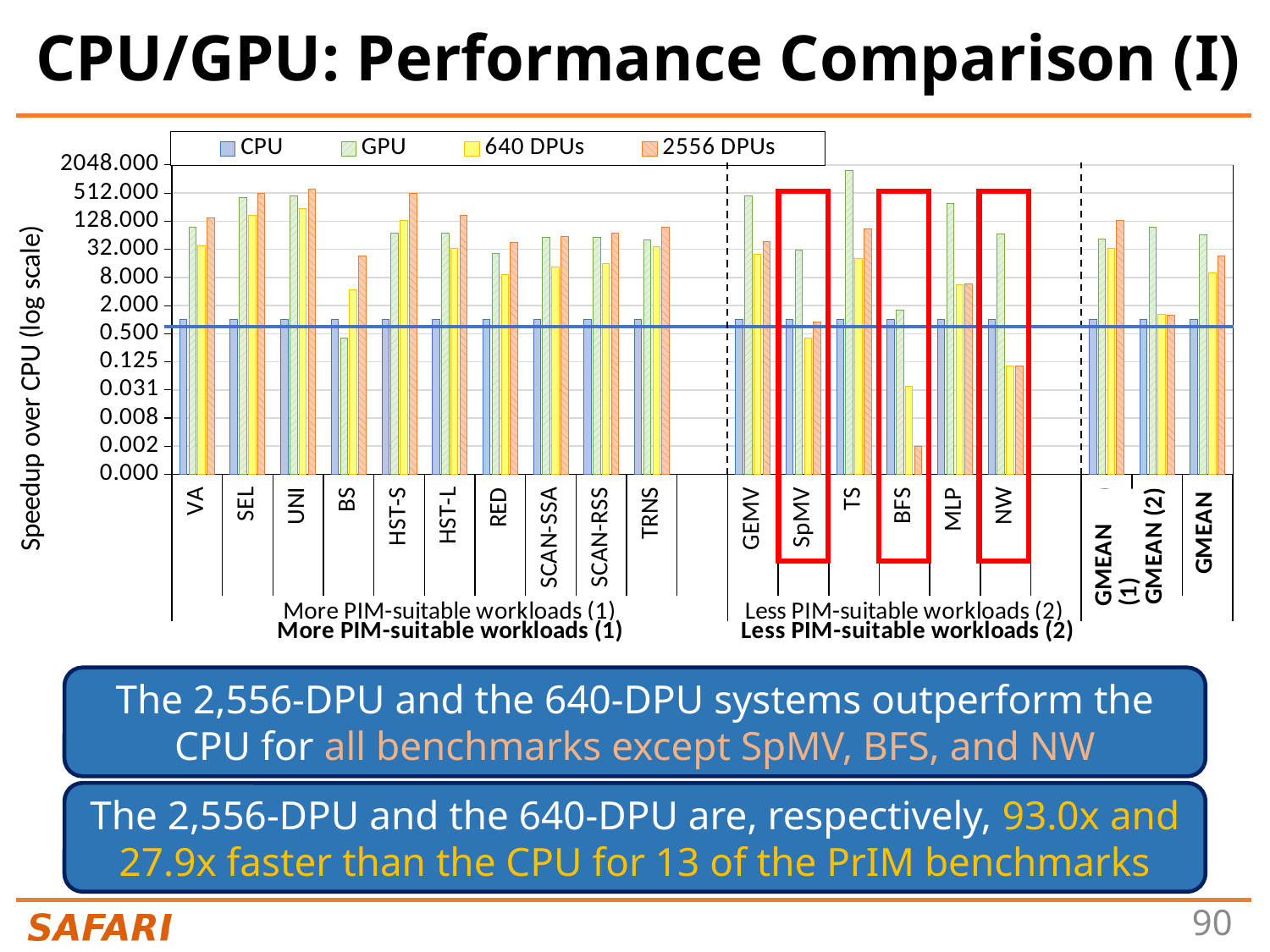
Is the 640 DPUs value for NW greater or less than 0.500? less What is the label of the y axis? Speedup over CPU (log scale) Which benchmark has the lowest 2556 DPUs speedup? BFS Is the 2556 DPUs value for GMEAN (1) greater or less than 32.000? greater Which three benchmarks are highlighted with red boxes? SpMV, BFS, and NW How many series does the chart legend list? 4 Which benchmark has the highest GPU speedup? TS For BS, which is larger: the GPU speedup or the 2556 DPUs speedup? 2556 DPUs What kind of chart is shown on the slide? bar chart Is the GPU value for TS greater or less than 512.000? greater How many benchmark categories (including the GMEAN entries) are shown along the x axis? 19